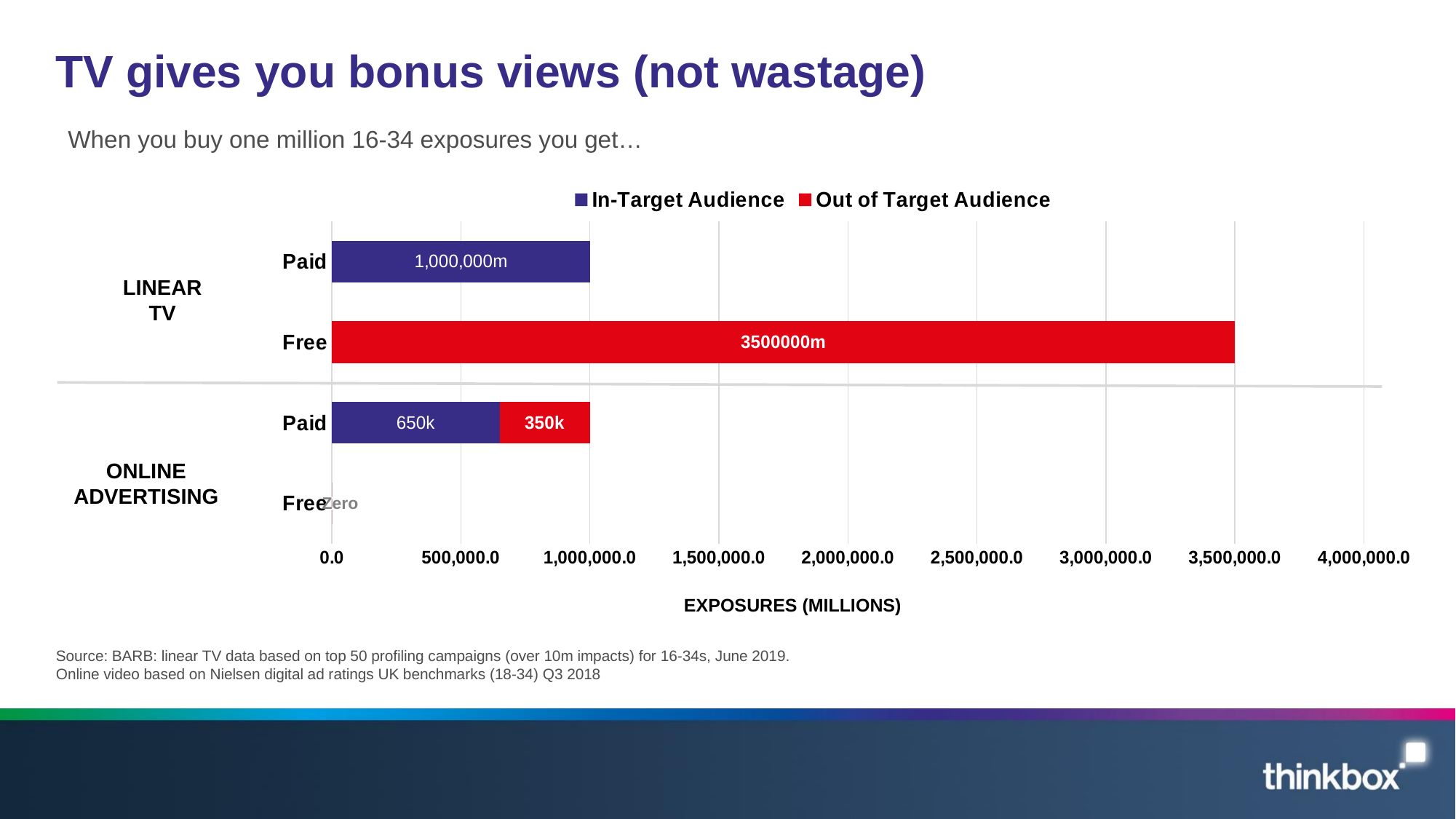
What is the Out of Target Audience value for Online Advertising Paid? 350k Is the Linear TV Free bar greater or less than 3,000,000.0 on the x axis? greater What is the In-Target Audience value for Online Advertising Paid? 650k What label is shown for Online Advertising Free? Zero What is the x-axis title of the chart? EXPOSURES (MILLIONS) How many series does the legend list? 2 Which is larger for Online Advertising Paid: the In-Target Audience value or the Out of Target Audience value? In-Target Audience What kind of chart is shown on the slide? bar chart Which bar is the longest in the chart? Linear TV Free What is the data label on the Out of Target Audience bar for Linear TV Free? 3500000m What is the data label on the In-Target Audience bar for Linear TV Paid? 1,000,000m Which colour represents the Out of Target Audience series in the legend? red